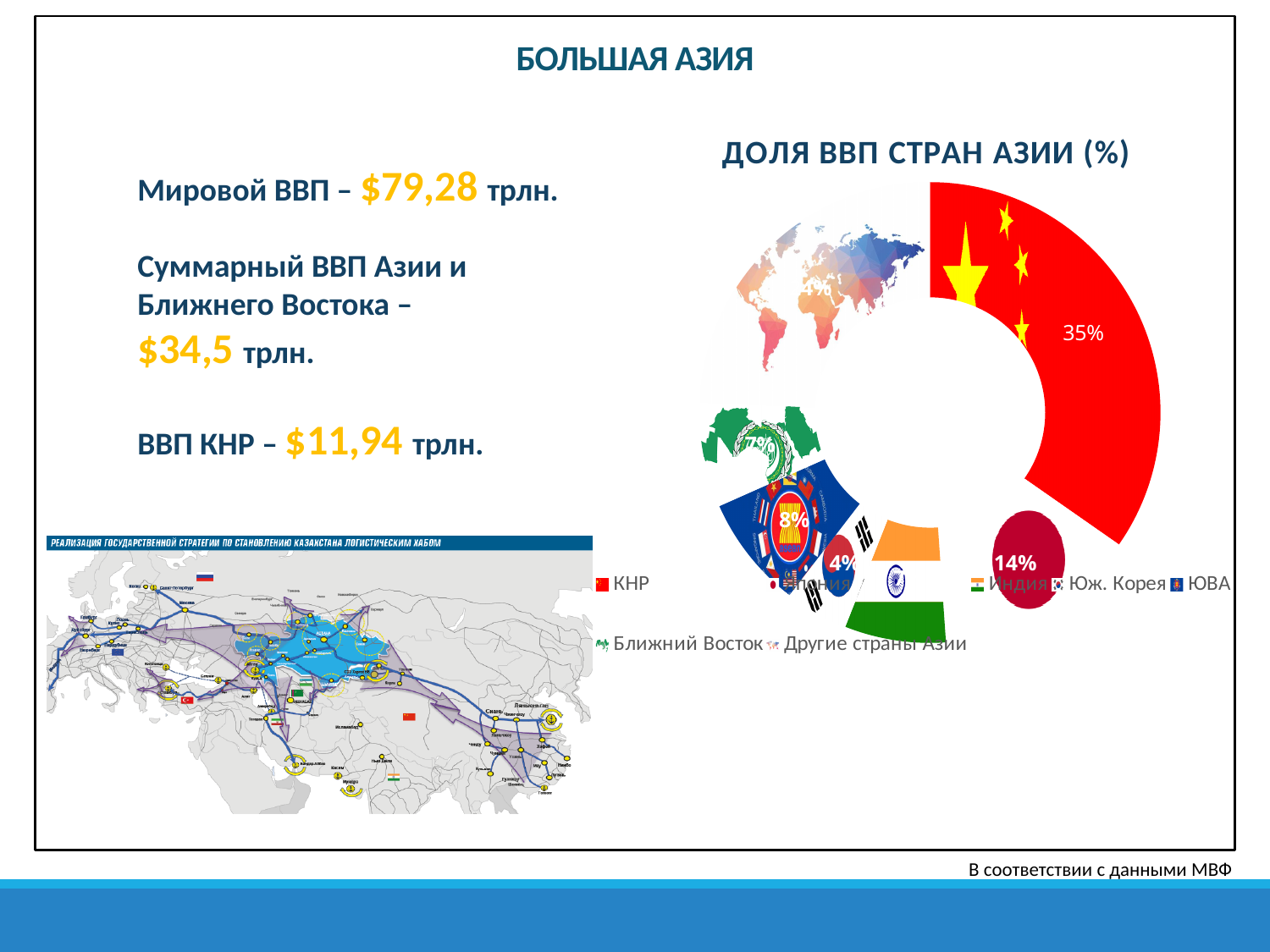
In the pie chart ДОЛЯ ВВП СТРАН АЗИИ (%), what share is shown for Ближний Восток? 7% In the pie chart ДОЛЯ ВВП СТРАН АЗИИ (%), what share is shown for Япония? 14% In the pie chart ДОЛЯ ВВП СТРАН АЗИИ (%), which has the larger share, ЮВА or Ближний Восток? ЮВА In the pie chart ДОЛЯ ВВП СТРАН АЗИИ (%), which country or region has the largest share? КНР In the pie chart ДОЛЯ ВВП СТРАН АЗИИ (%), how many percentage points larger is the share of КНР than the share of Япония? 21% What kind of chart is shown under the title ДОЛЯ ВВП СТРАН АЗИИ (%)? doughnut chart In the pie chart ДОЛЯ ВВП СТРАН АЗИИ (%), what share is shown for Юж. Корея? 4% How many entries does the legend of the pie chart ДОЛЯ ВВП СТРАН АЗИИ (%) list? 7 In the pie chart ДОЛЯ ВВП СТРАН АЗИИ (%), what share is shown for ЮВА? 8% How many slices does the pie chart ДОЛЯ ВВП СТРАН АЗИИ (%) have? 7 In the pie chart ДОЛЯ ВВП СТРАН АЗИИ (%), what share is shown for КНР? 35% What is the title of the pie chart on the slide? ДОЛЯ ВВП СТРАН АЗИИ (%)